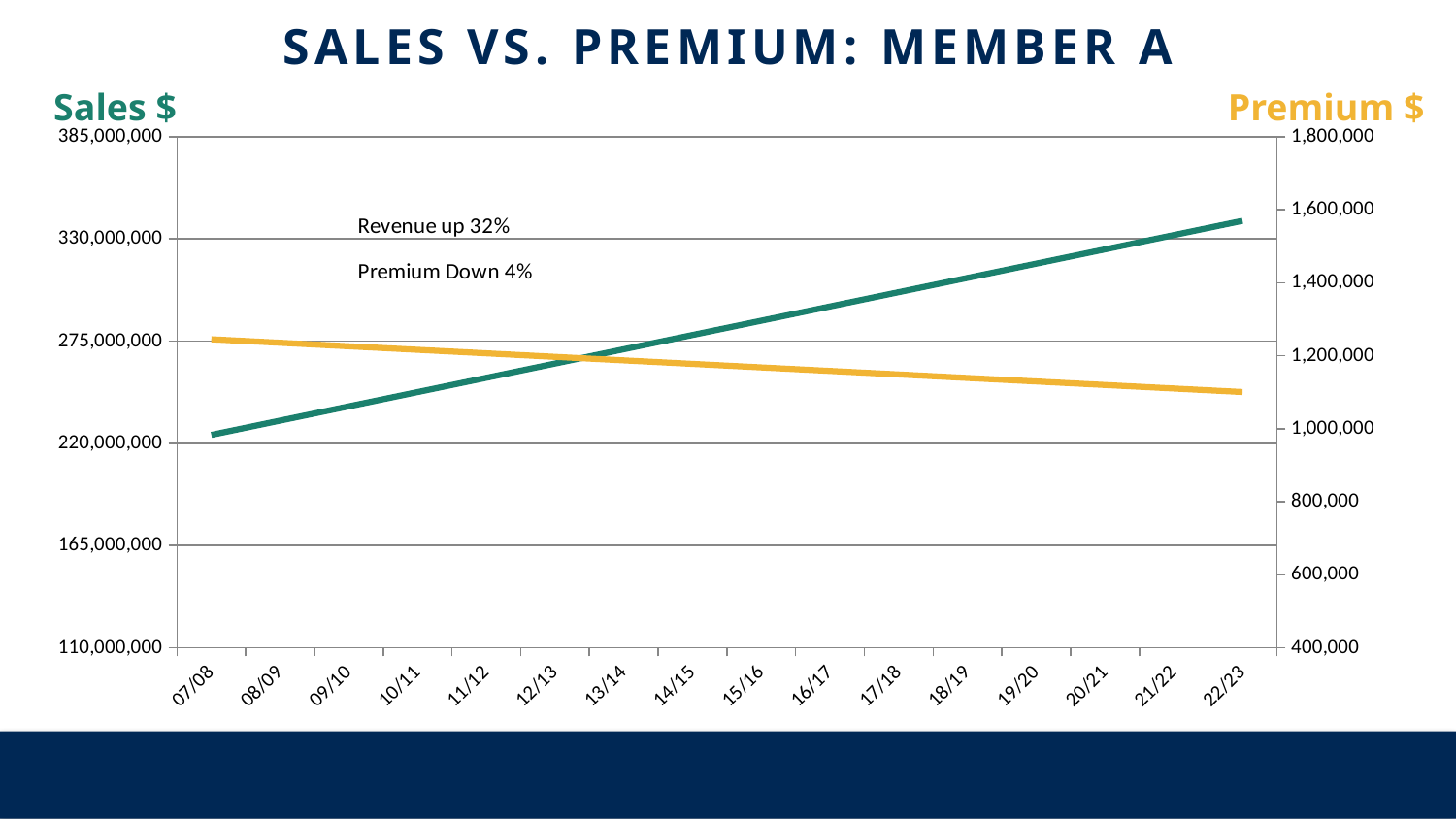
What is the title of the chart? SALES VS. PREMIUM: MEMBER A Is the Premium $ value for 22/23 greater or less than 1,200,000? less Does the Premium $ line rise or fall from 07/08 to 22/23? fall Does the Sales $ line rise or fall from 07/08 to 22/23? rise How many fiscal-year categories are shown on the x axis? 16 In which year is Premium $ highest? 07/08 In which year is Sales $ lowest? 07/08 In which year is Sales $ highest? 22/23 How many lines are plotted on the chart? 2 Which colour is used for the Premium $ line? yellow What kind of chart is shown on the slide? line chart Is the Sales $ value for 22/23 greater or less than 275,000,000? greater